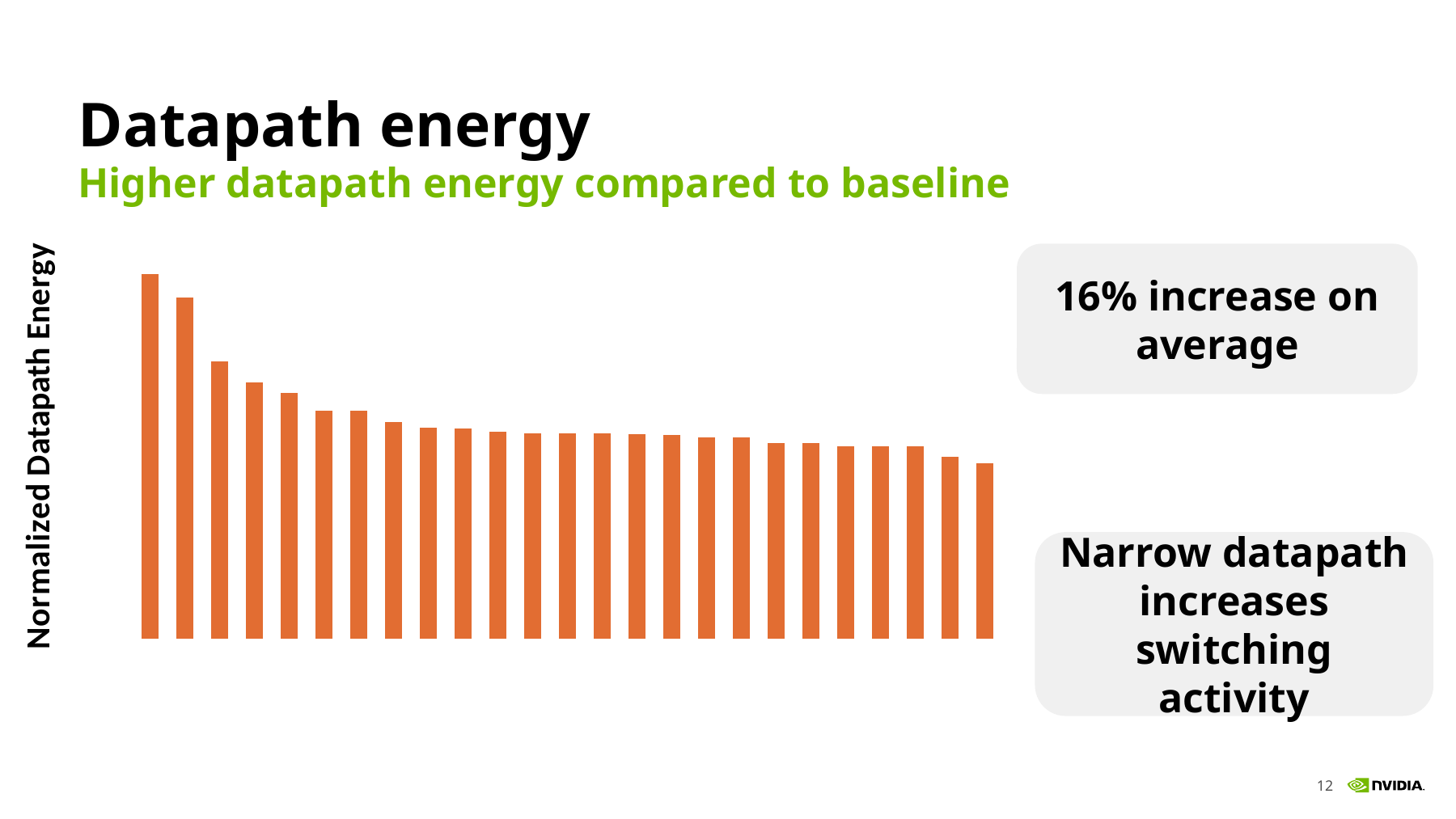
What is the label on the vertical axis of the chart? Normalized Datapath Energy Is the leftmost bar taller or shorter than the rightmost bar? taller How many bars are plotted in the chart? 25 Which bar is the shortest in the chart? the rightmost bar Do the bar values rise or fall from left to right across the chart? fall What colour are the bars in the chart? orange Which bar is the tallest in the chart? the leftmost bar What kind of chart is shown on the slide? bar chart